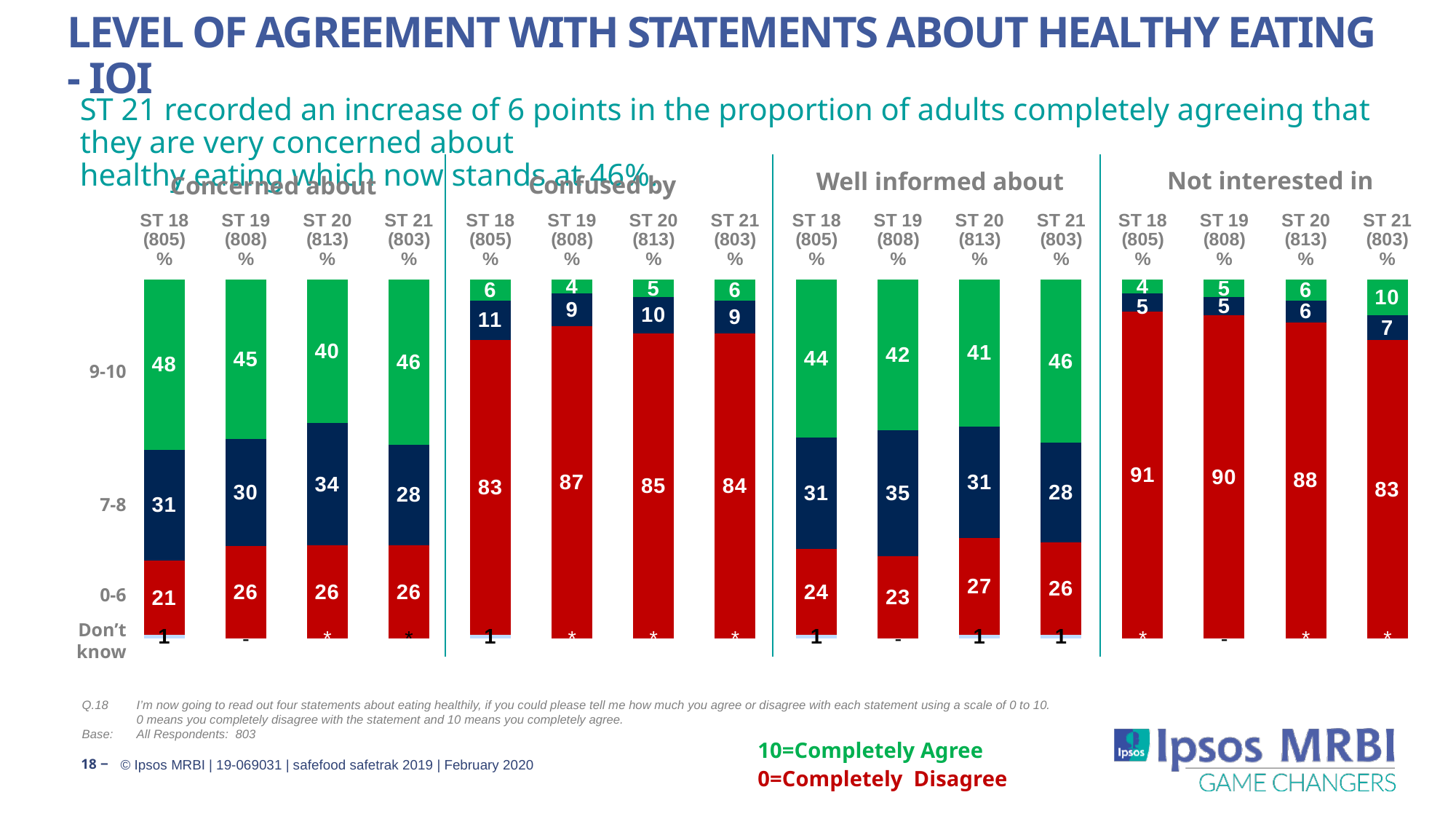
What type of chart is used on this slide? Stacked bar chart In the 'Not interested in' chart, what percentage gave a 9-10 rating in ST 21? 10 In the 'Concerned about' chart, what percentage of adults gave a 9-10 rating in ST 21? 46 In the 'Not interested in' chart, which wave has the highest 0-6 percentage? ST 18 In the 'Not interested in' chart, does the 0-6 percentage rise or fall from ST 18 to ST 21? Fall In the 'Confused by' chart, which wave has the larger 7-8 percentage, ST 18 or ST 21? ST 18 In the 'Well informed about' chart, which wave has the larger 7-8 percentage, ST 19 or ST 21? ST 19 In the 'Confused by' chart, what percentage gave a 0-6 rating in ST 19? 87 In the 'Well informed about' chart, by how many points did the 9-10 percentage change from ST 20 to ST 21? 5 How many survey waves are shown in each chart panel? 4 In the 'Concerned about' chart, which wave has the lowest 9-10 percentage? ST 20 In the 'Concerned about' chart, what is the difference in the 0-6 percentage between ST 19 and ST 18? 5